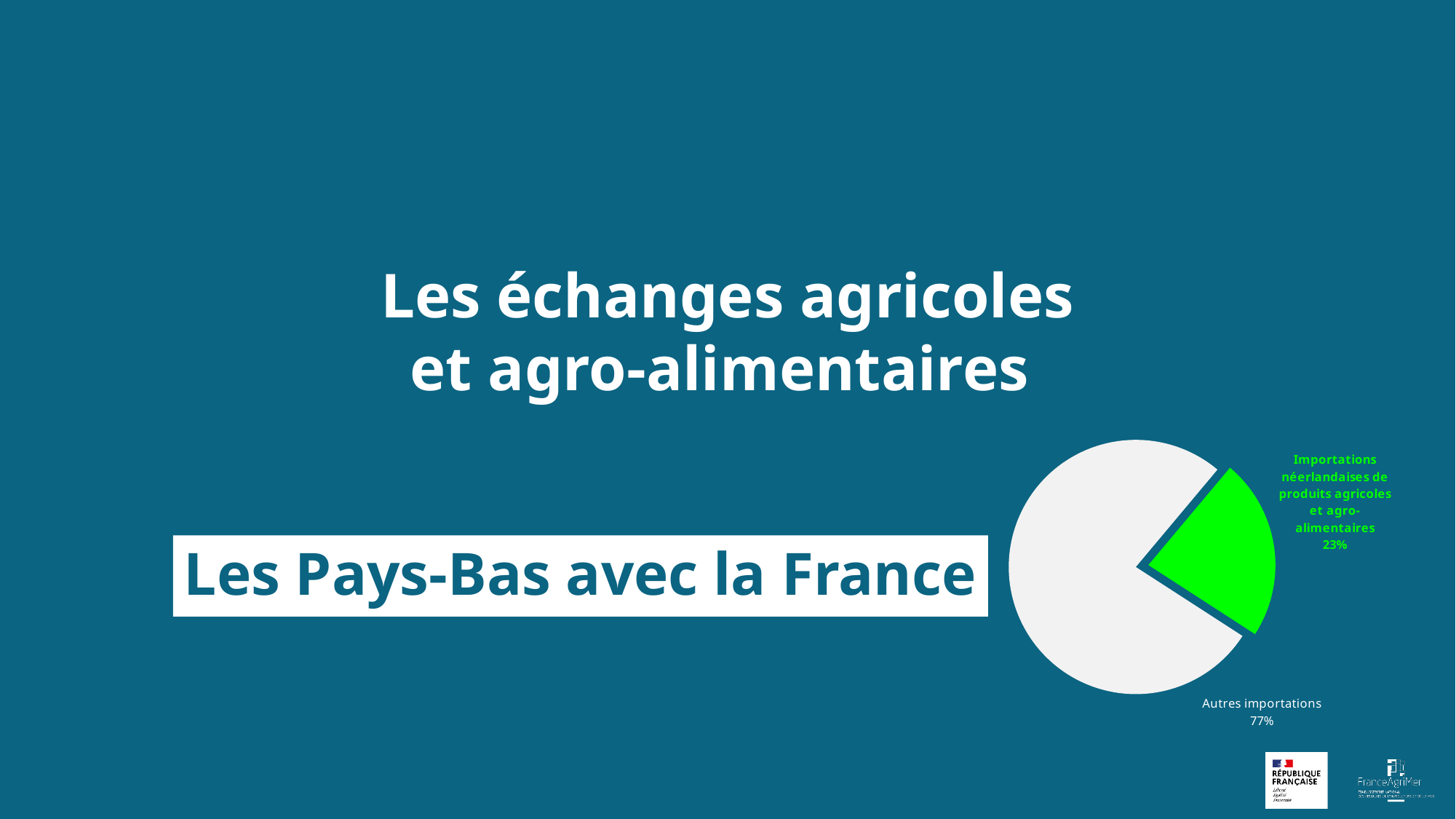
What colour is the slice for 'Autres importations'? white What share of the pie is labelled 'Autres importations'? 77% Which slice of the pie is the largest? Autres importations What kind of chart is shown on the slide? pie chart Which slice of the pie is the smallest? Importations néerlandaises de produits agricoles et agro-alimentaires How many slices does the pie chart have? 2 What colour is the slice for 'Importations néerlandaises de produits agricoles et agro-alimentaires'? green Which is larger: 'Autres importations' or 'Importations néerlandaises de produits agricoles et agro-alimentaires'? Autres importations What share of the pie is labelled 'Importations néerlandaises de produits agricoles et agro-alimentaires'? 23% What is the difference in percentage points between 'Autres importations' and 'Importations néerlandaises de produits agricoles et agro-alimentaires'? 54